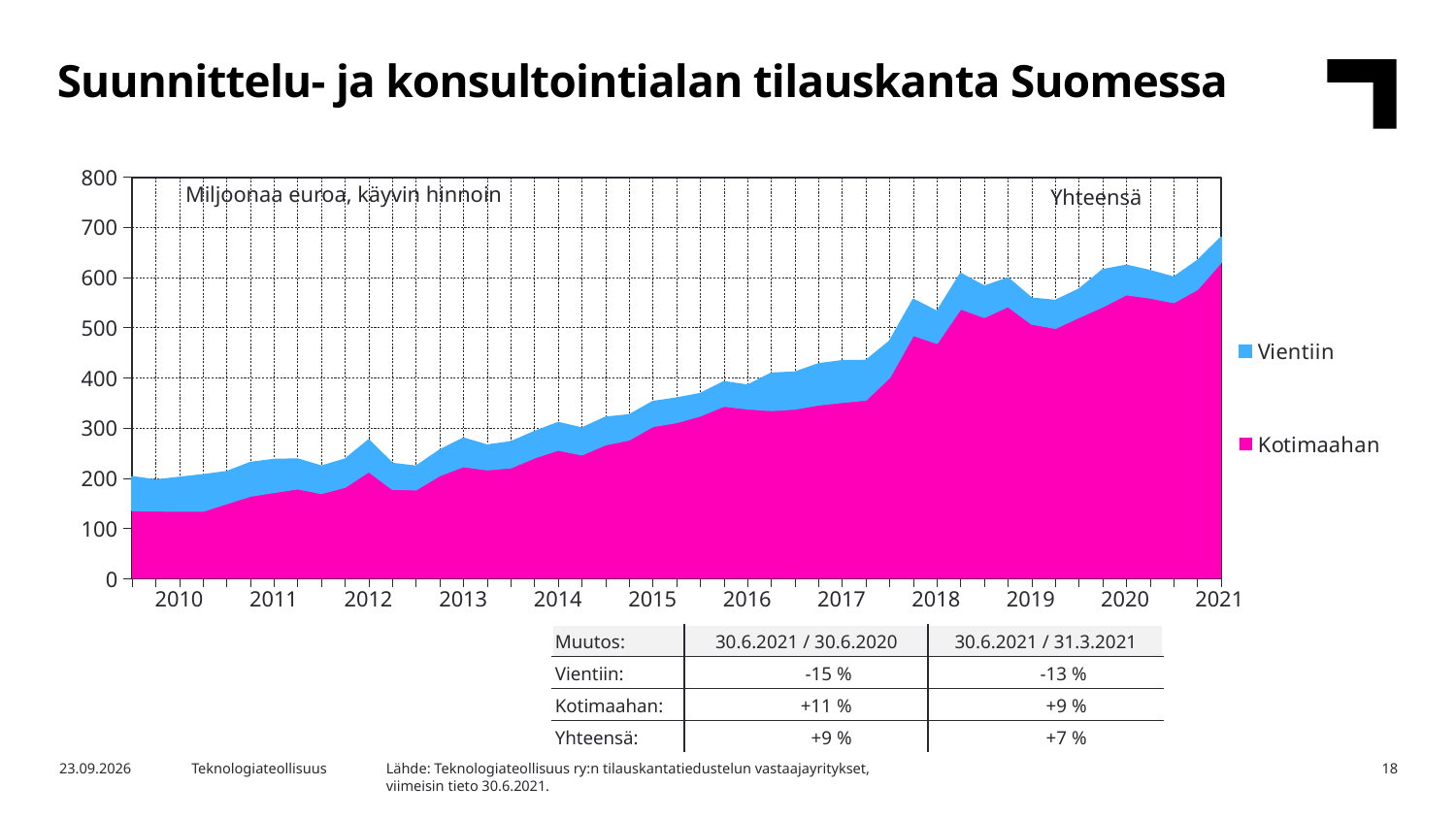
Which series is larger throughout the chart, Vientiin or Kotimaahan? Kotimaahan Is the total value (Yhteensä) in 2015 greater or less than 400? less What unit is stated in the label inside the chart area? Miljoonaa euroa, käyvin hinnoin What kind of chart is shown on the slide? Area chart What are the two series named in the chart legend? Vientiin and Kotimaahan According to the table below the chart, what is the change in Vientiin for 30.6.2021 / 30.6.2020? -15 % How many year labels are shown on the x axis? 12 How many series does the chart legend list? 2 Is the Kotimaahan value at the start of 2010 greater or less than 200? less Does the total order backlog (Yhteensä) generally rise or fall from 2010 to 2021? Rise Is the Kotimaahan value in 2021 greater or less than 500? greater